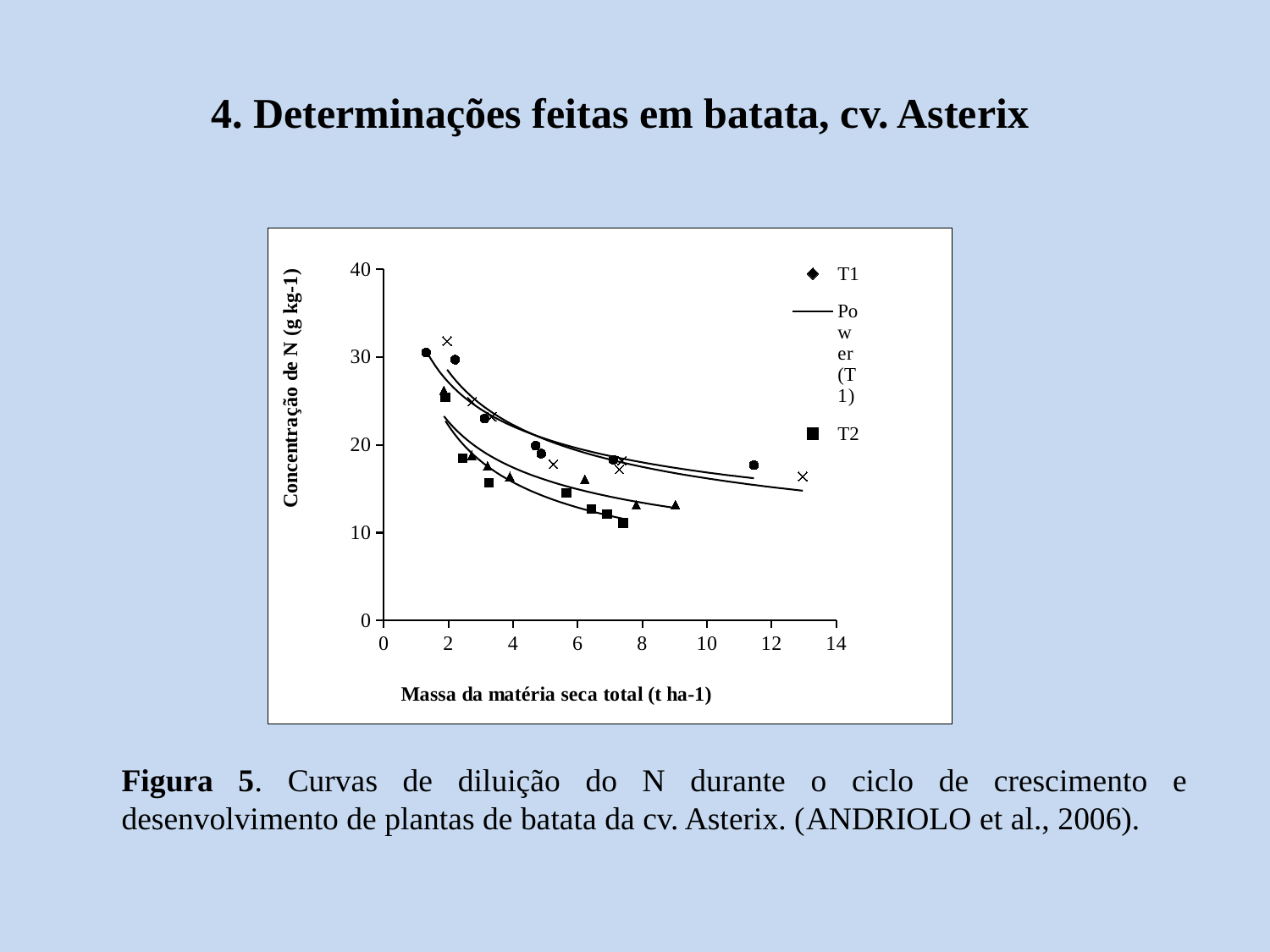
Do the N concentration values rise or fall as total dry matter mass increases along the x axis? fall Is the highest plotted N concentration on the chart greater or less than 30? greater What is the label of the x axis? Massa da matéria seca total (t ha-1) What is the highest tick value shown on the x axis? 14 What is the highest tick value shown on the y axis? 40 Is the N concentration of the lowest T2 point (near 7.4 t ha-1) greater or less than 15? less What kind of chart is shown on the slide? scatter chart What is the label of the y axis? Concentração de N (g kg-1) Is the N concentration of the lowest T2 point (near 7.4 t ha-1) greater or less than 10? greater